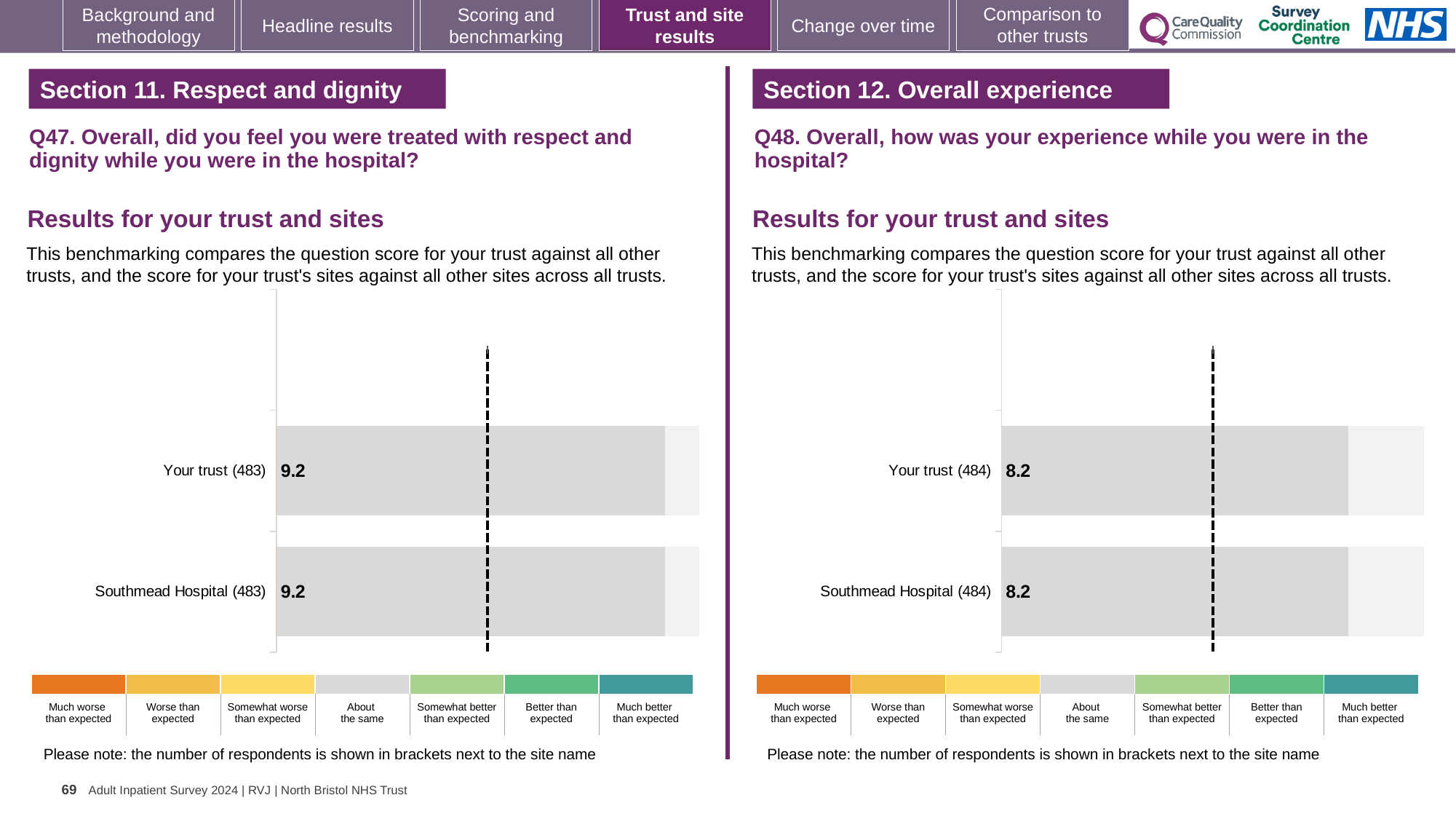
On the Q47 chart (left), how many respondents are shown in brackets next to Southmead Hospital? 483 On the Q47 chart (left), what is the score for Southmead Hospital? 9.2 On the Q47 chart (left), what is the score for Your trust? 9.2 How many bars are plotted on the Q48 chart (right)? 2 On the Q48 chart (right), which benchmark category does the grey colour of the bars correspond to in the legend? About the same On the Q48 chart (right), what is the score for Your trust? 8.2 On the Q47 chart (left), what is the difference between the Your trust score and the Southmead Hospital score? 0 On the Q48 chart (right), what is the score for Southmead Hospital? 8.2 On the Q48 chart (right), what is the difference between the Your trust score and the Southmead Hospital score? 0 What kind of chart is used on the Q47 chart (left)? Bar chart How many bars are plotted on the Q47 chart (left)? 2 On the Q48 chart (right), how many respondents are shown in brackets next to Your trust? 484